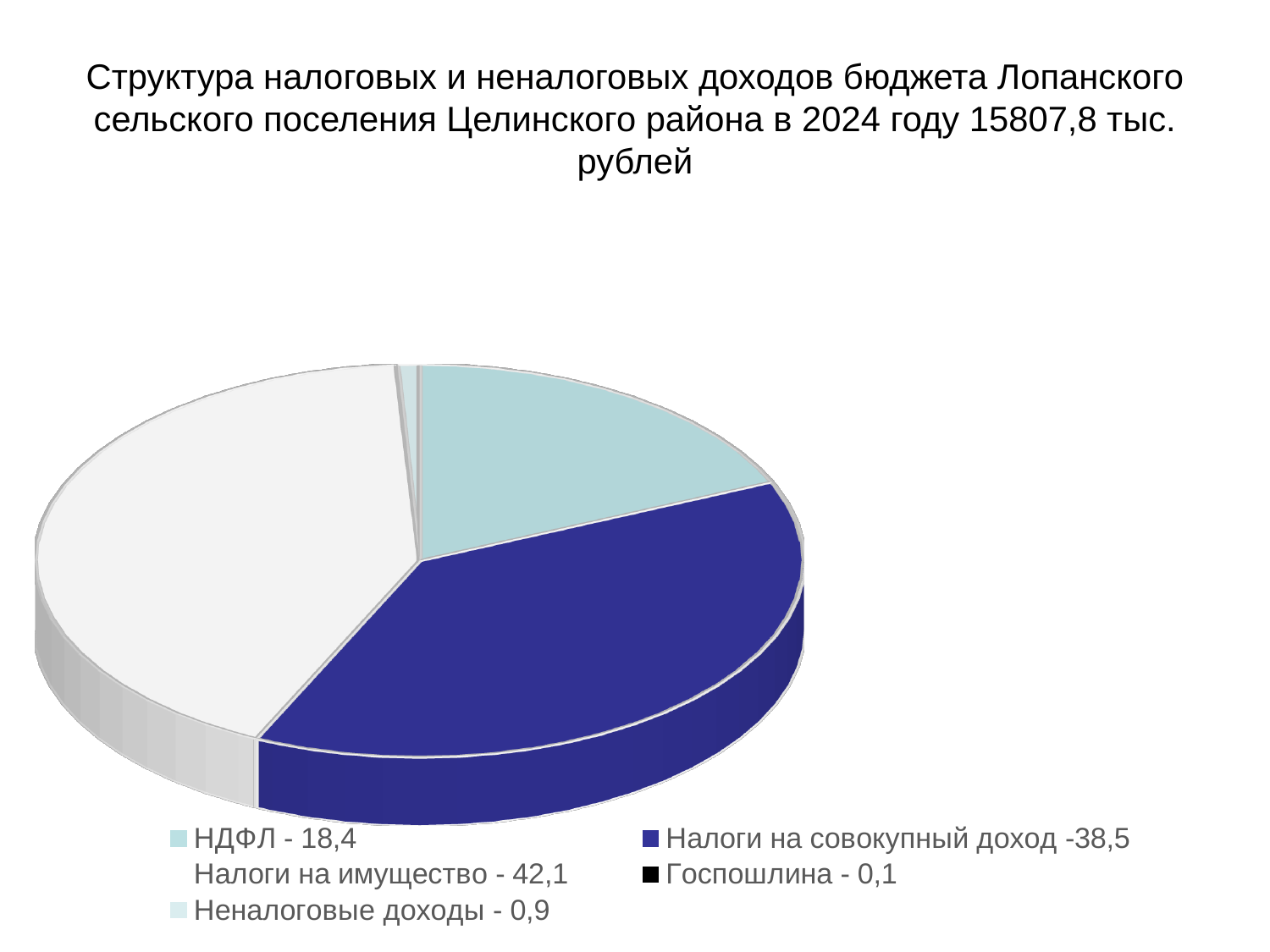
What value is shown for Неналоговые доходы? 0,9 What value is shown for НДФЛ in the legend? 18,4 Which category has the largest share of the pie? Налоги на имущество Which category has the smallest share of the pie? Госпошлина What value is shown for Налоги на имущество? 42,1 What total amount in thousand rubles is stated in the chart title for 2024? 15807,8 тыс. рублей What is the difference between the values for Налоги на имущество and Налоги на совокупный доход? 3,6 What value is shown for Госпошлина? 0,1 What value is shown for Налоги на совокупный доход? 38,5 How many categories does the pie chart's legend list? 5 Which is larger, the value for НДФЛ or the value for Налоги на совокупный доход? Налоги на совокупный доход What kind of chart is shown on the slide? Pie chart